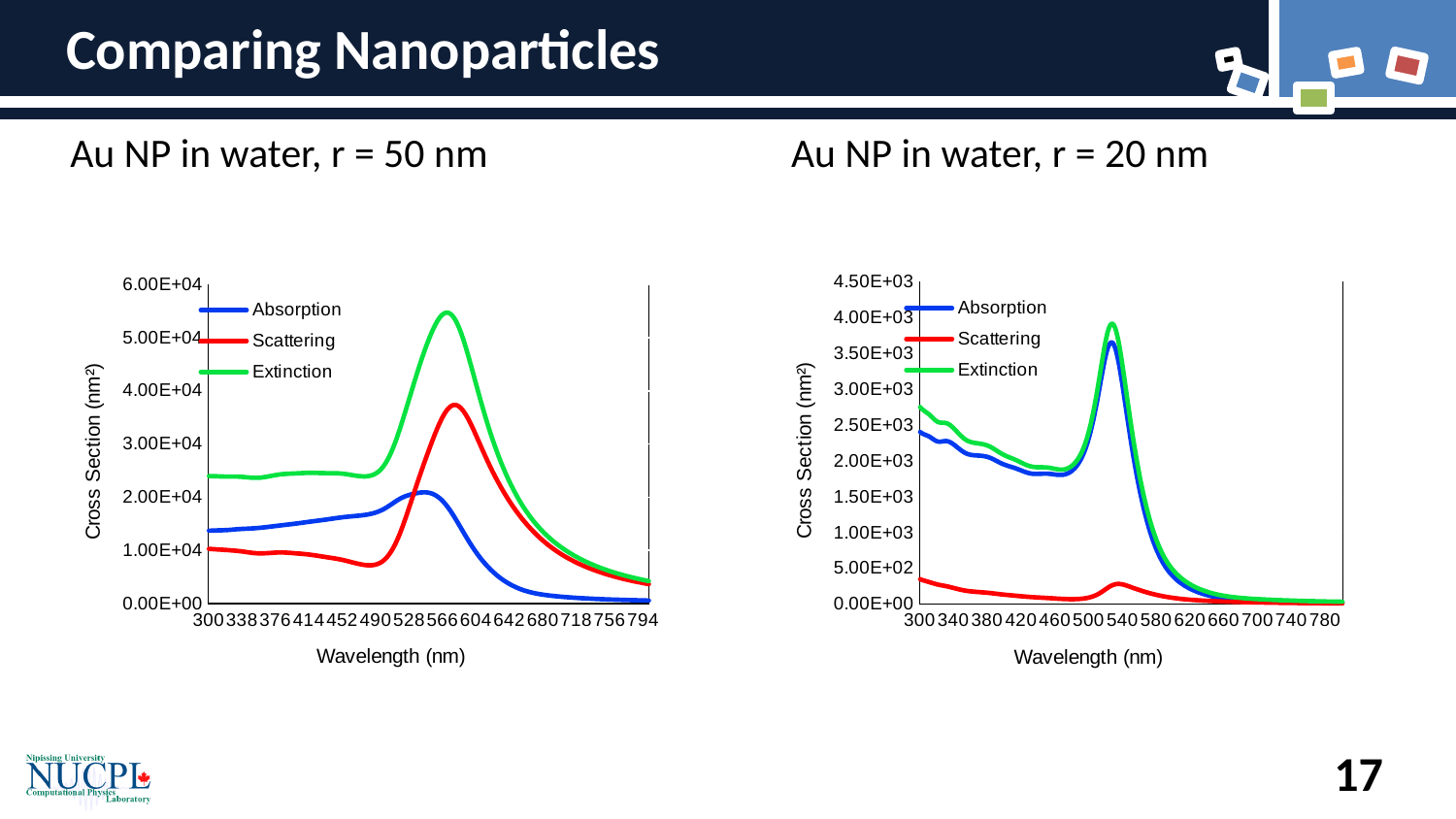
On the 'Au NP in water, r = 50 nm' chart, is the peak value of the Absorption series greater or less than 3.00E+04? less On the 'Au NP in water, r = 50 nm' chart, which series has the lowest peak, Absorption or Scattering? Absorption On the 'Au NP in water, r = 20 nm' chart, which series has the lowest peak? Scattering On the 'Au NP in water, r = 50 nm' chart, does the Absorption series rise or fall between 604 nm and 794 nm? fall What is the x-axis label on the 'Au NP in water, r = 20 nm' chart? Wavelength (nm) What are the legend entries on the 'Au NP in water, r = 50 nm' chart? Absorption, Scattering, Extinction On the 'Au NP in water, r = 50 nm' chart, is the Scattering value at 300 nm greater or less than 2.00E+04? less What kind of chart is the 'Au NP in water, r = 50 nm' chart? line chart On the 'Au NP in water, r = 50 nm' chart, is the peak value of the Extinction series greater or less than 5.00E+04? greater How many series does the legend of the 'Au NP in water, r = 20 nm' chart list? 3 On the 'Au NP in water, r = 50 nm' chart, which series has the highest peak? Extinction